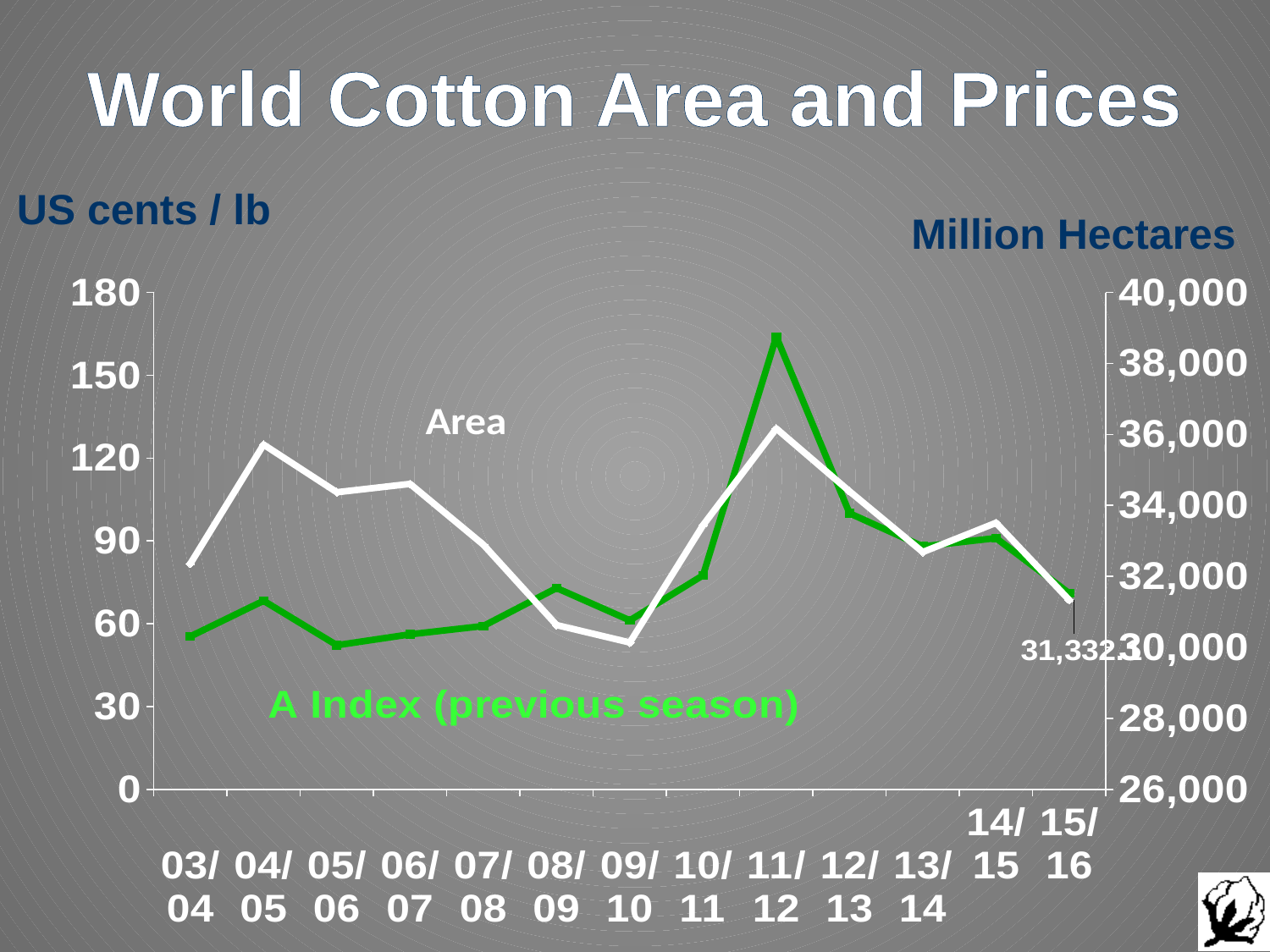
In which season does the Area series reach its highest value? 11/12 Is the Area value for 04/05 greater or less than 34,000? greater Is the Area value for 09/10 greater or less than 32,000? less Which season has the higher A Index (previous season) value, 04/05 or 05/06? 04/05 How many seasons are shown along the x axis? 13 How many series are plotted on the chart? 2 In which season does the A Index (previous season) reach its highest value? 11/12 What unit is shown on the left axis of the chart? US cents / lb Does the A Index (previous season) rise or fall from 11/12 to 15/16? fall Is the A Index (previous season) value for 11/12 greater or less than 150? greater What kind of chart is shown on the slide? line chart In which season is the Area series at its lowest? 09/10